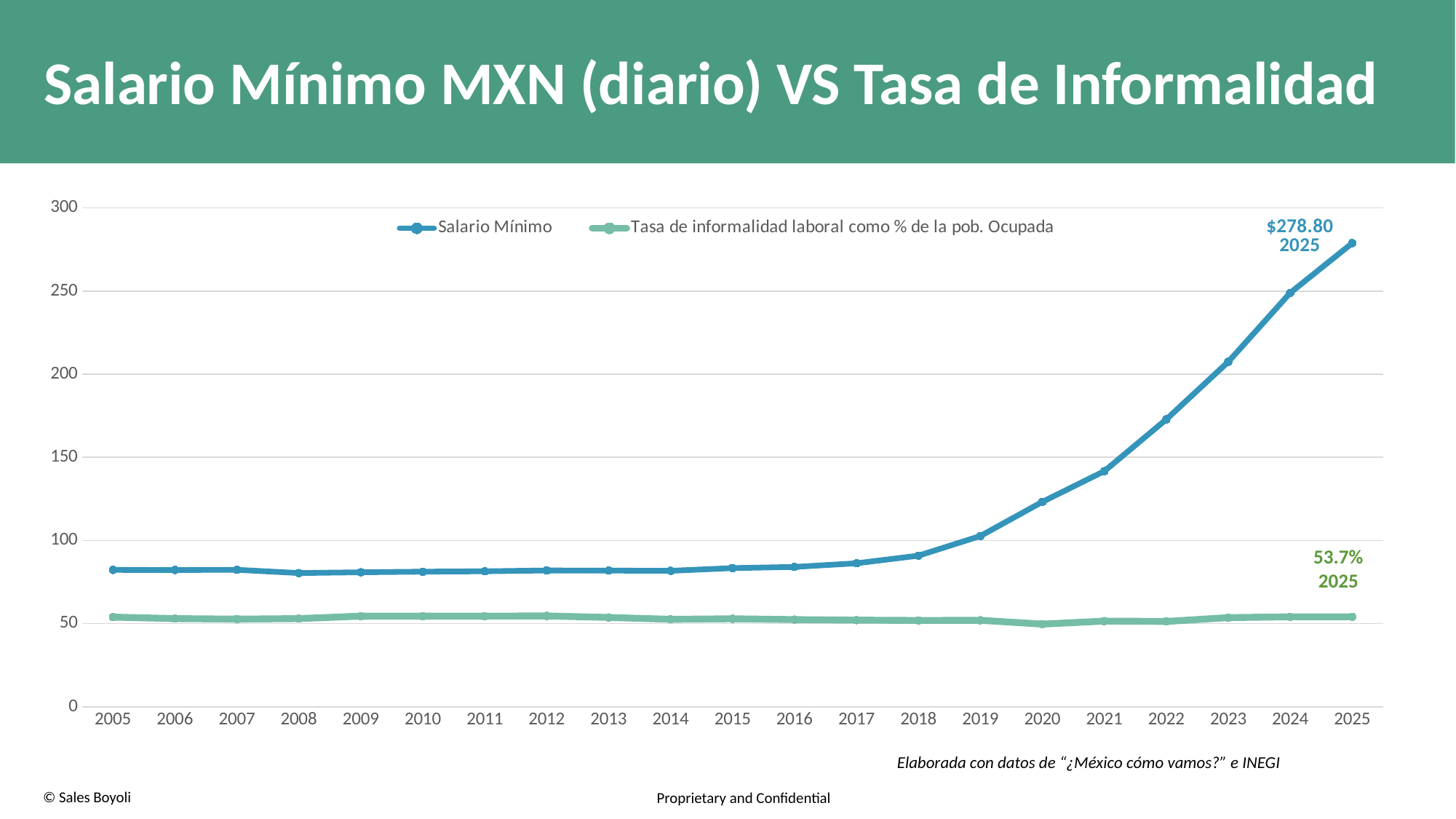
In which year is the Salario Mínimo highest? 2025 How many years are shown on the x axis? 21 How many series does the legend list? 2 Is the Salario Mínimo value for 2021 greater or less than 100? greater What is the title of the chart? Salario Mínimo MXN (diario) VS Tasa de Informalidad What kind of chart is shown on the slide? line chart What is the value of Tasa de informalidad laboral como % de la pob. Ocupada in 2025? 53.7% What is the value of Salario Mínimo in 2025? $278.80 Does the Salario Mínimo series rise or fall from 2018 to 2025? rise Is the Salario Mínimo value for 2015 greater or less than 100? less Which is larger in 2025, Salario Mínimo or Tasa de informalidad laboral como % de la pob. Ocupada? Salario Mínimo Is the Salario Mínimo value for 2023 greater or less than 200? greater